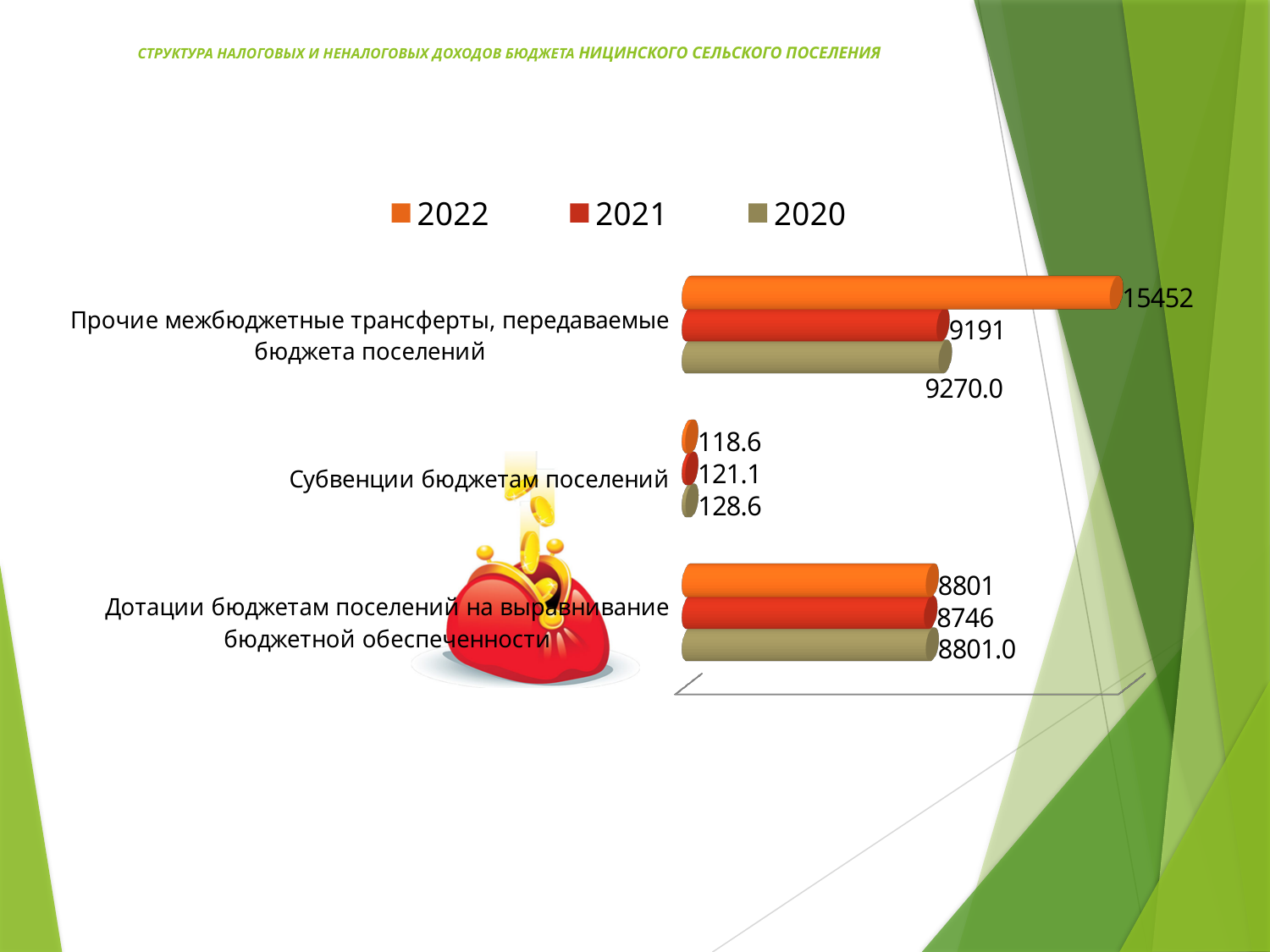
What is the 2022 value for «Прочие межбюджетные трансферты, передаваемые бюджета поселений»? 15452 Which category has the lowest 2021 value? Субвенции бюджетам поселений What is the difference between the 2022 and 2021 values for «Прочие межбюджетные трансферты, передаваемые бюджета поселений»? 6261 How many series does the legend list? 3 What is the 2020 value for «Прочие межбюджетные трансферты, передаваемые бюджета поселений»? 9270.0 What is the 2020 value for «Субвенции бюджетам поселений»? 128.6 What is the 2021 value for «Дотации бюджетам поселений на выравнивание бюджетной обеспеченности»? 8746 For «Субвенции бюджетам поселений», which year has the larger value, 2021 or 2022? 2021 How many categories are shown on the chart? 3 What kind of chart is shown on the slide? Bar chart What is the difference between the 2020 and 2022 values for «Субвенции бюджетам поселений»? 10.0 Which category has the highest 2022 value? Прочие межбюджетные трансферты, передаваемые бюджета поселений